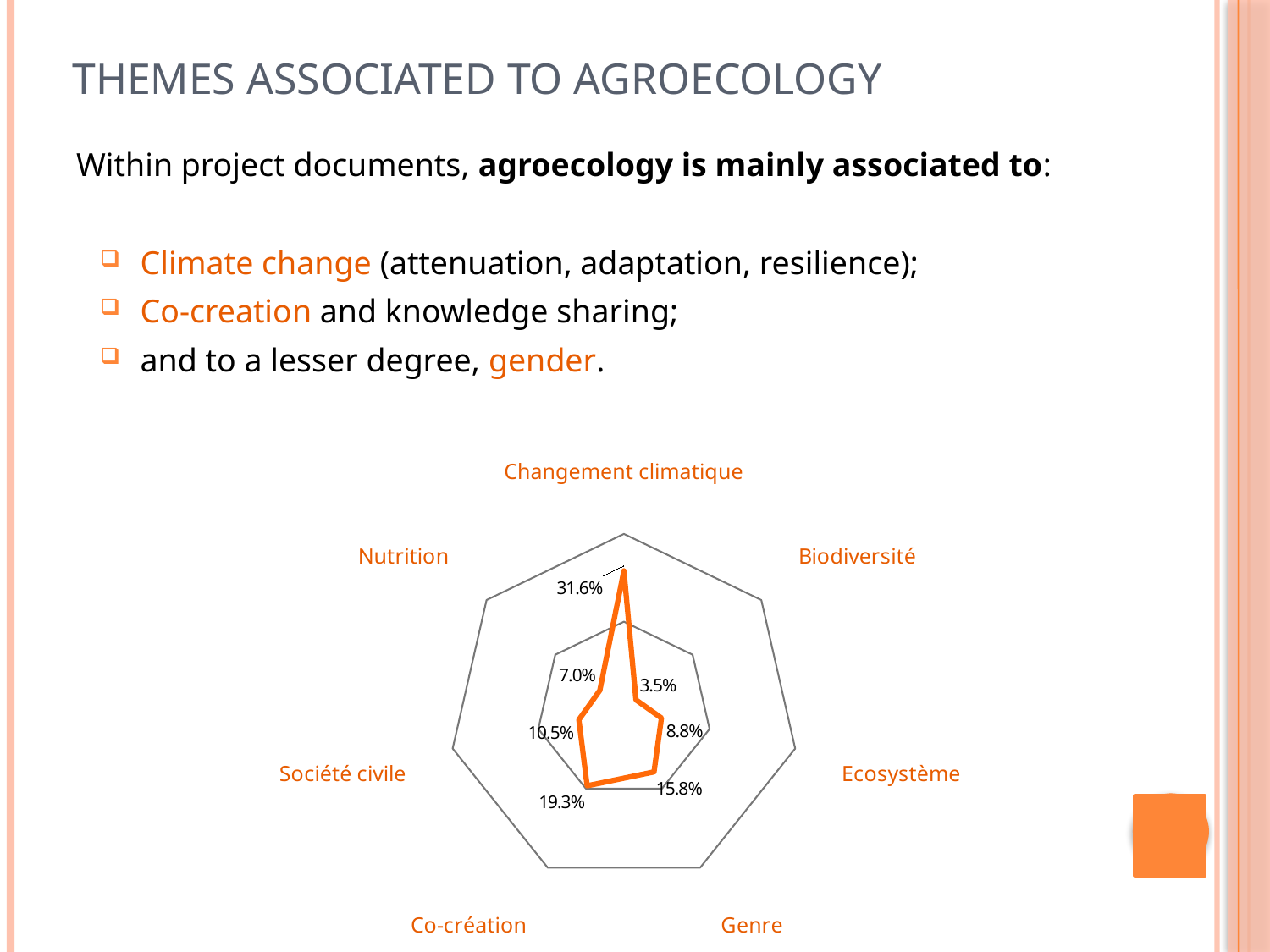
What is the difference between the values for Changement climatique and Co-création? 12.3% What is the difference between the values for Genre and Ecosystème? 7.0% What is the value for Co-création? 19.3% Which category has the highest value? Changement climatique How many categories (axes) does the radar chart have? 7 What is the value for Biodiversité? 3.5% Which category has the lowest value? Biodiversité What is the value for Société civile? 10.5% Which is larger, the value for Ecosystème or the value for Nutrition? Ecosystème What kind of chart is shown on the slide? Radar chart What is the value for Genre? 15.8% What is the value for Changement climatique? 31.6%